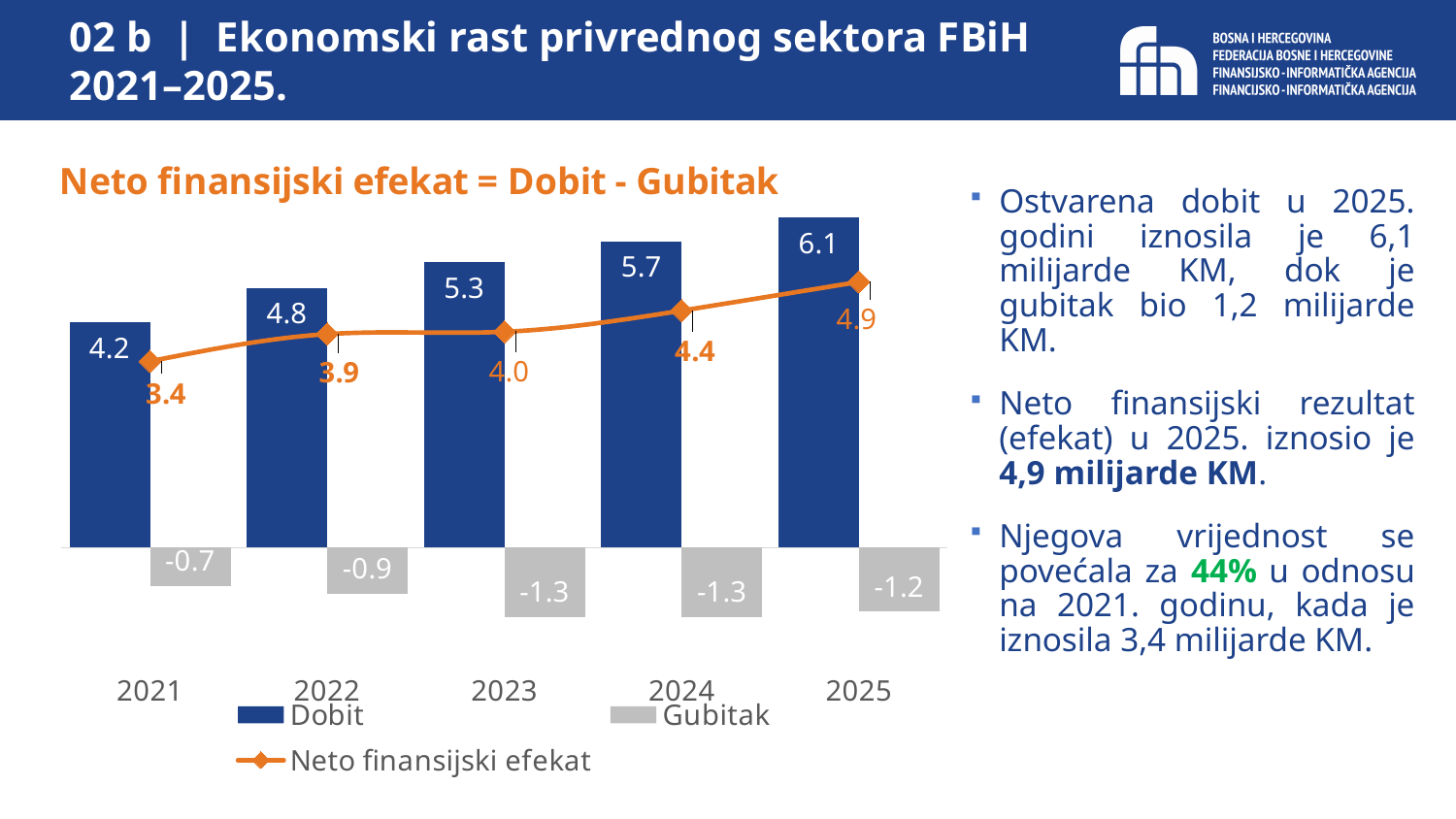
Does the Neto finansijski efekat rise or fall from 2021 to 2025? Rises How many series does the legend list? 3 What is the Dobit value for 2025? 6.1 What is the Gubitak value for 2022? -0.9 How many years are shown on the x axis? 5 In which year is Dobit the highest? 2025 What is the Neto finansijski efekat value for 2023? 4.0 Which is larger: Dobit in 2022 or Dobit in 2023? Dobit in 2023 What is the difference between Dobit in 2025 and Dobit in 2021? 1.9 What kind of chart is this? Combination bar and line chart In which year is the Neto finansijski efekat the lowest? 2021 What is the title of the chart? Neto finansijski efekat = Dobit - Gubitak